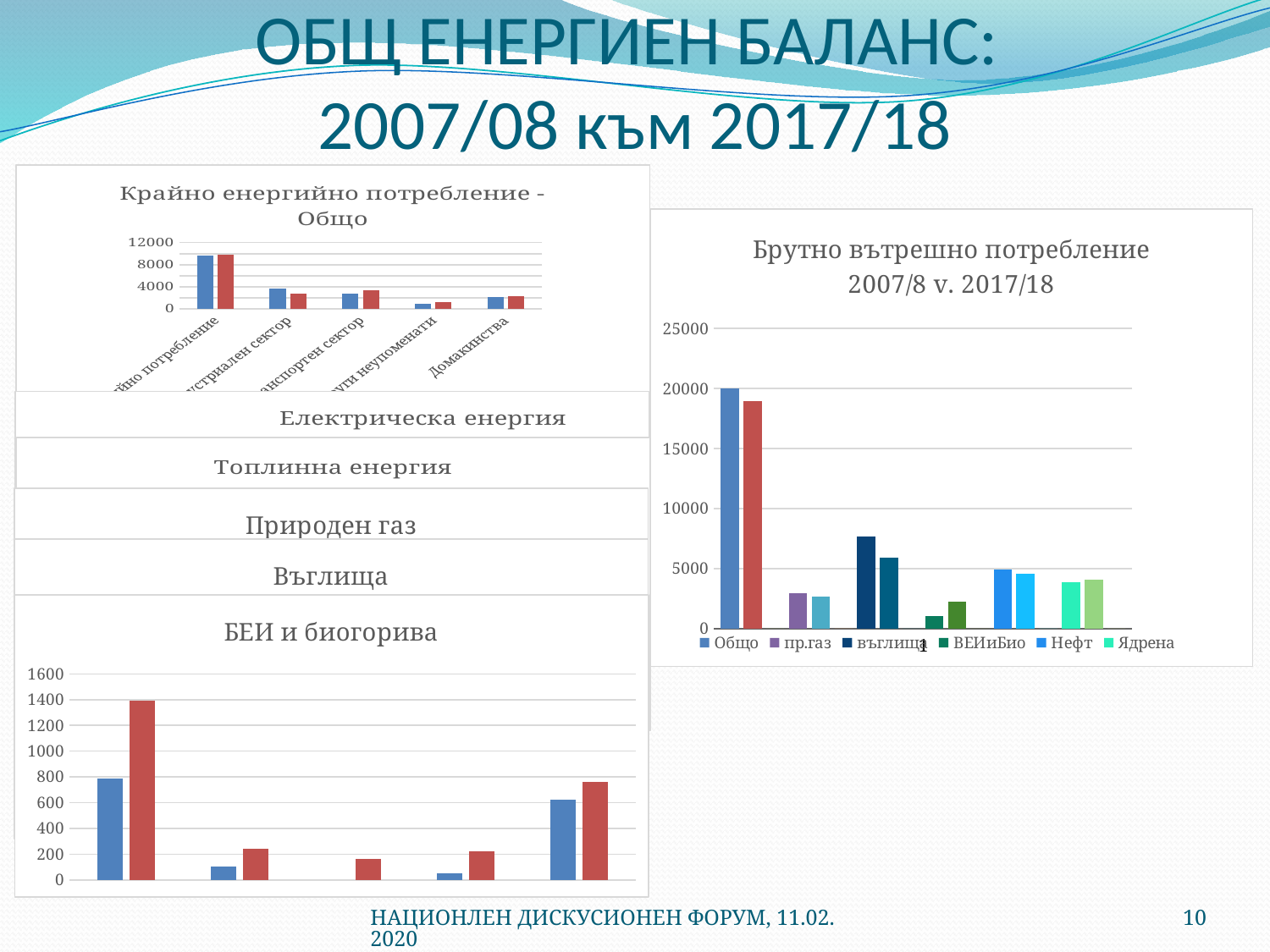
How many series does the legend of the 'Брутно вътрешно потребление 2007/8 v. 2017/18' chart list? 6 In the 'Крайно енергийно потребление - Общо' chart at the top left, is the blue bar for Домакинства greater or less than 4000? less In the 'Брутно вътрешно потребление 2007/8 v. 2017/18' chart, is the first (left) bar for въглища greater or less than 5000? greater In the 'Брутно вътрешно потребление 2007/8 v. 2017/18' chart, which legend entry has the tallest bars? Общо In the 'Брутно вътрешно потребление 2007/8 v. 2017/18' chart, for въглища, is the first (left) bar taller or shorter than the second (right) bar? taller In the 'Брутно вътрешно потребление 2007/8 v. 2017/18' chart, for ВЕИиБио, which bar is taller, the first (left) or the second (right)? the second (right) In the 'Брутно вътрешно потребление 2007/8 v. 2017/18' chart, is the first (left) bar for Общо greater or less than 15000? greater What kind of chart is the 'Брутно вътрешно потребление 2007/8 v. 2017/18' chart on the right? bar chart In the 'БЕИ и биогорива' chart at the bottom left, in the leftmost group, which bar is taller, the blue or the red? red In the 'БЕИ и биогорива' chart at the bottom left, how many groups of bars are plotted? 5